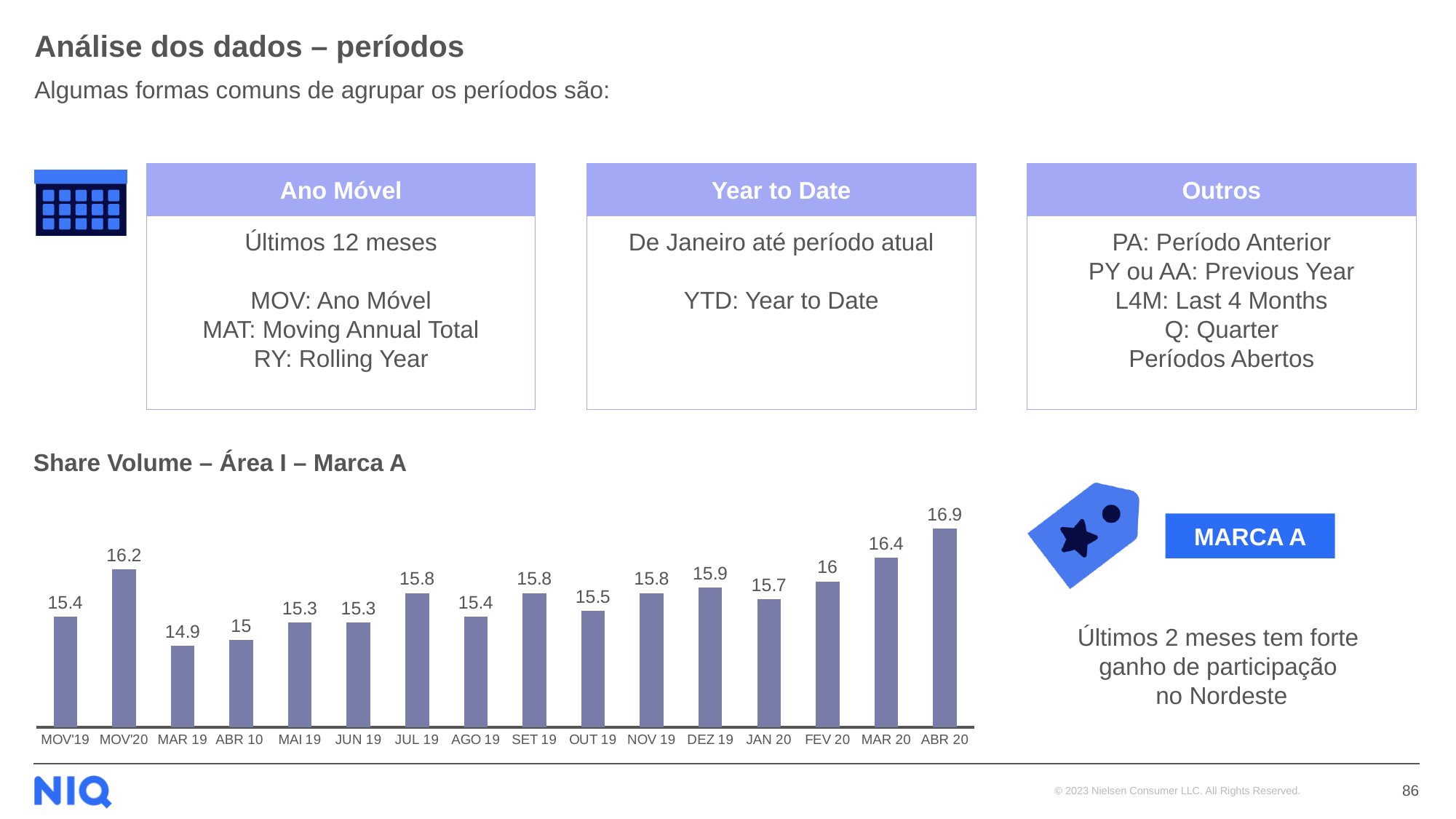
What is the value for MAR 19 in the Share Volume – Área I – Marca A chart? 14.9 What kind of chart is the Share Volume – Área I – Marca A chart? Bar chart Which category has the highest value in the Share Volume – Área I – Marca A chart? ABR 20 What is the difference between the values for ABR 20 and MAR 20 in the Share Volume – Área I – Marca A chart? 0.5 Which category has the lowest value in the Share Volume – Área I – Marca A chart? MAR 19 What is the value for ABR 20 in the Share Volume – Área I – Marca A chart? 16.9 What is the difference between the values for MOV'20 and MOV'19 in the Share Volume – Área I – Marca A chart? 0.8 What is the value for DEZ 19 in the Share Volume – Área I – Marca A chart? 15.9 Do the values in the Share Volume – Área I – Marca A chart rise or fall from JAN 20 to ABR 20? Rise Which is larger in the Share Volume – Área I – Marca A chart, the value for FEV 20 or the value for JAN 20? FEV 20 How many bars are shown in the Share Volume – Área I – Marca A chart? 16 What is the value for MOV'20 in the Share Volume – Área I – Marca A chart? 16.2